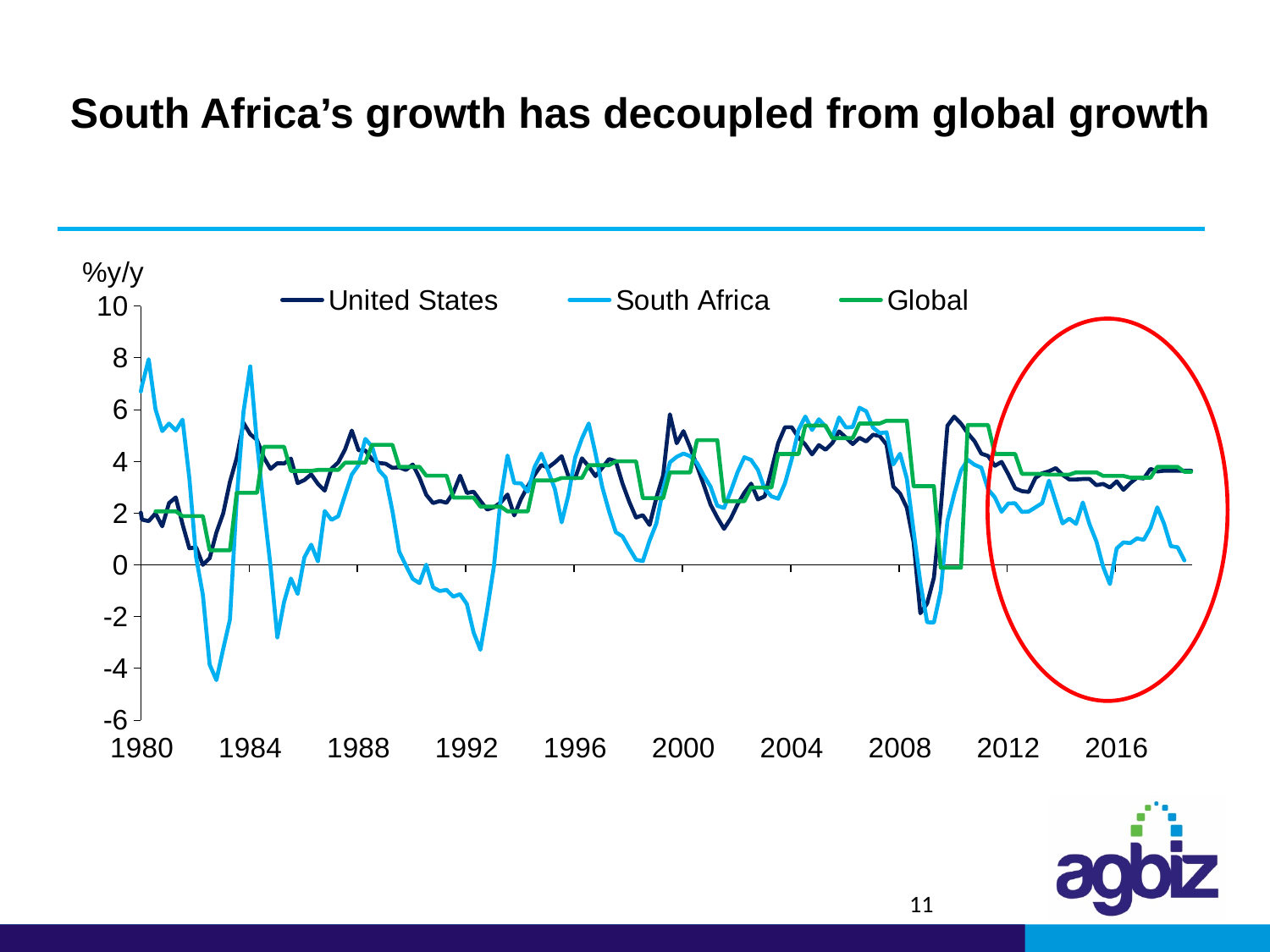
How many series does the legend list? 3 Does the South Africa line generally rise or fall between 2012 and 2018? fall Around 2016, which is higher: the Global line or the South Africa line? Global At the right-hand end of the chart (2018), which is higher: the United States line or the South Africa line? United States Is the United States value at its 2009 low greater or less than 0? less Which series reaches the highest value anywhere on the chart? South Africa What is the label on the vertical axis of the chart? %y/y Which series reaches the lowest value anywhere on the chart? South Africa What kind of chart is shown on the slide? line chart Which three series are listed in the chart legend? United States, South Africa, Global Is the lowest value of the South Africa line (around 1983) greater or less than -2? less Is the peak of the South Africa line around 1984 greater or less than 6? greater